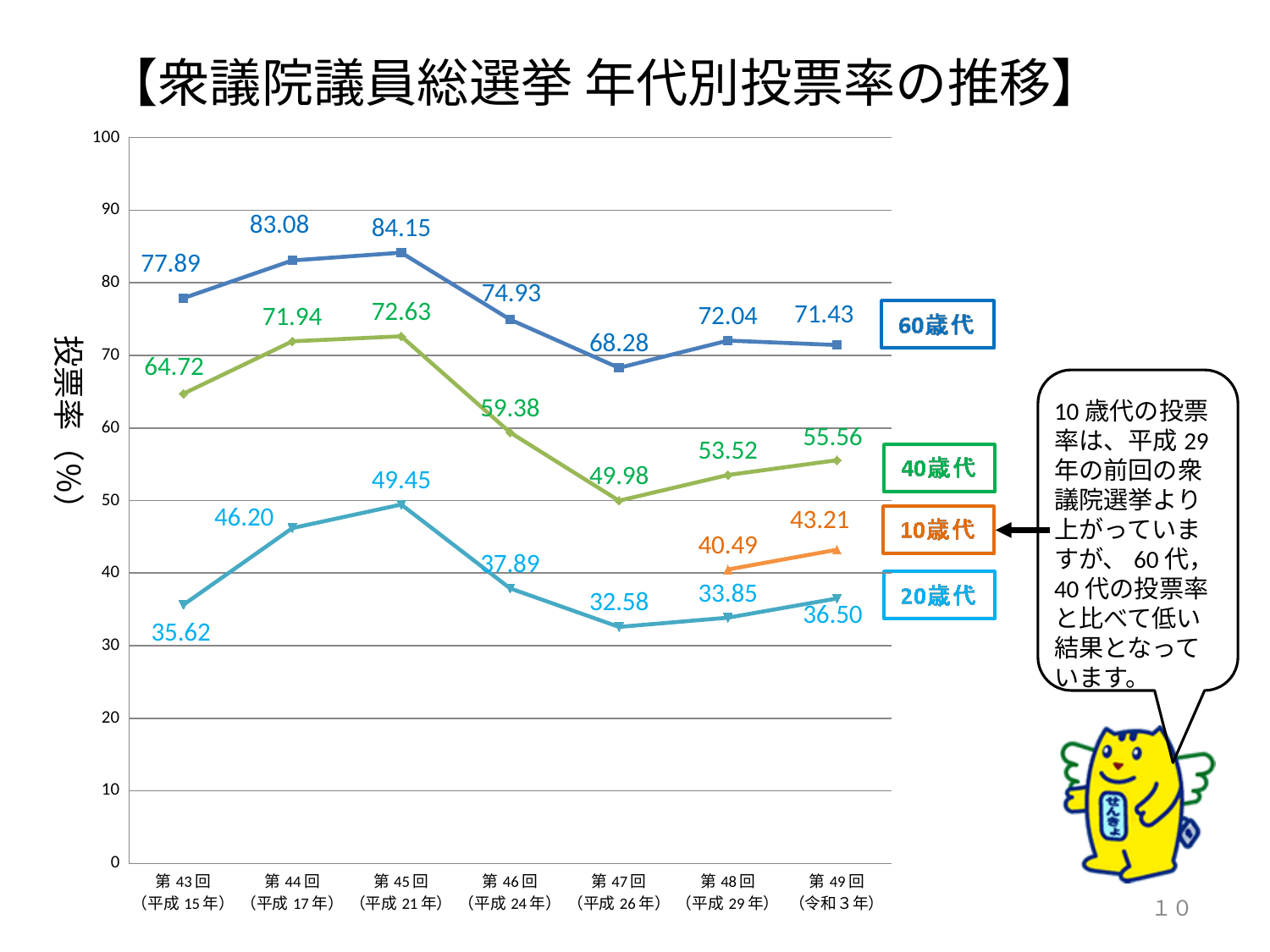
What is the voter turnout for 60歳代 at 第45回 (平成21年)? 84.15 What type of chart is shown on the slide? line chart Which is larger at 第48回 (平成29年): the turnout for 10歳代 or for 20歳代? 10歳代 What is the voter turnout for 20歳代 at 第47回 (平成26年)? 32.58 What is the voter turnout for 10歳代 at 第49回 (令和3年)? 43.21 Does the 60歳代 turnout rise or fall from 第45回 (平成21年) to 第47回 (平成26年)? fall How many elections are shown on the x axis? 7 What is the difference between the 60歳代 and 40歳代 turnout at 第49回 (令和3年)? 15.87 At which election does the 20歳代 series reach its lowest value? 第47回 (平成26年) What is the voter turnout for 40歳代 at 第46回 (平成24年)? 59.38 At which election does the 40歳代 series reach its highest value? 第45回 (平成21年) How many age-group series are plotted on the chart? 4